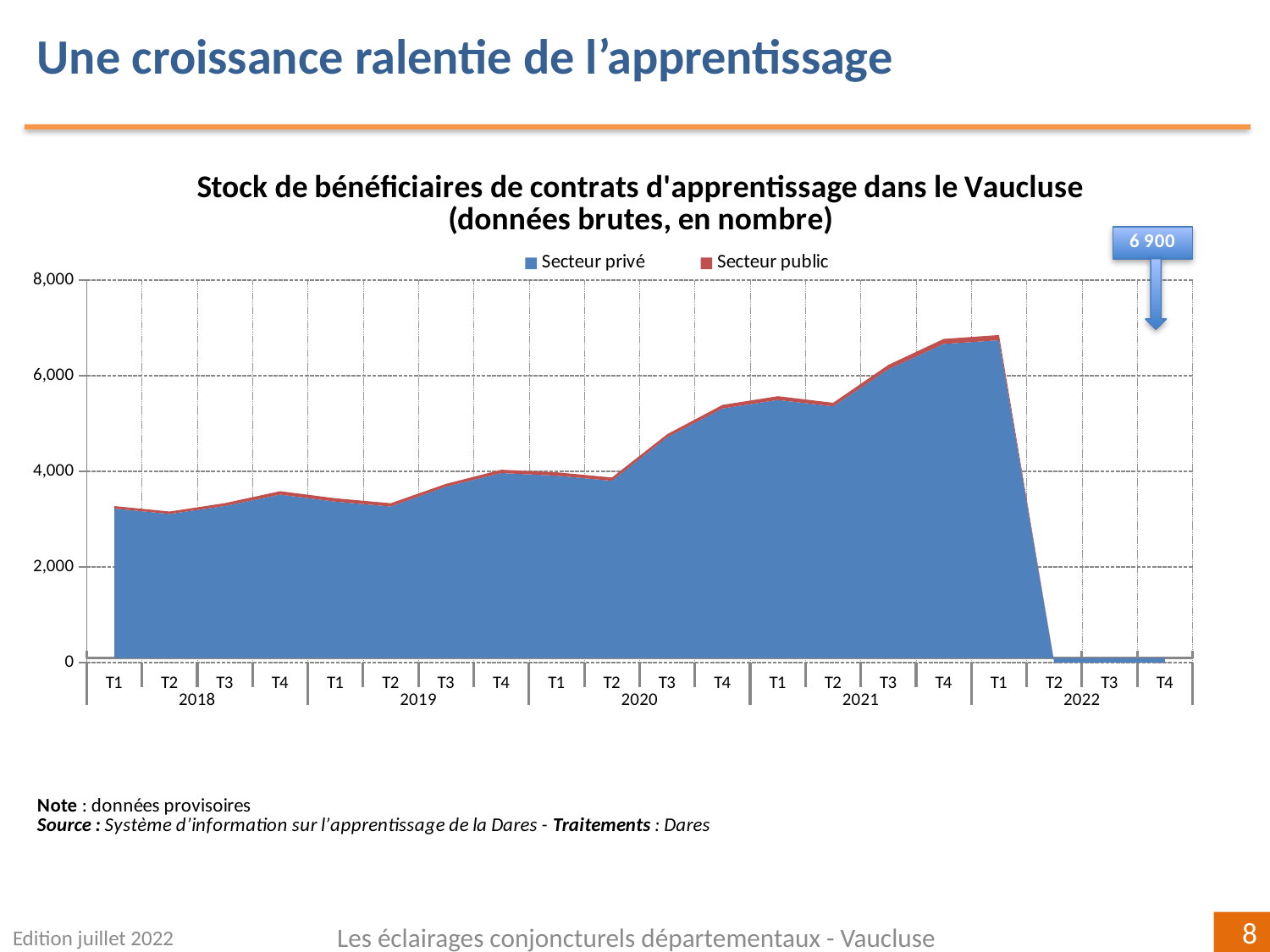
Is the value for T1 2018 greater or less than 4,000? less Which series accounts for almost all of the stacked area, Secteur privé or Secteur public? Secteur privé Is the value for T1 2021 greater or less than 4,000? greater Is the value for T3 2020 greater or less than 4,000? greater How many series does the legend list? 2 What kind of chart is shown on the slide? Area chart Do the values rise or fall from T2 2020 to T1 2022? rise How many years are labelled along the x axis? 5 Which is larger, the value for T1 2021 or the value for T1 2019? T1 2021 What are the two series named in the legend? Secteur privé and Secteur public